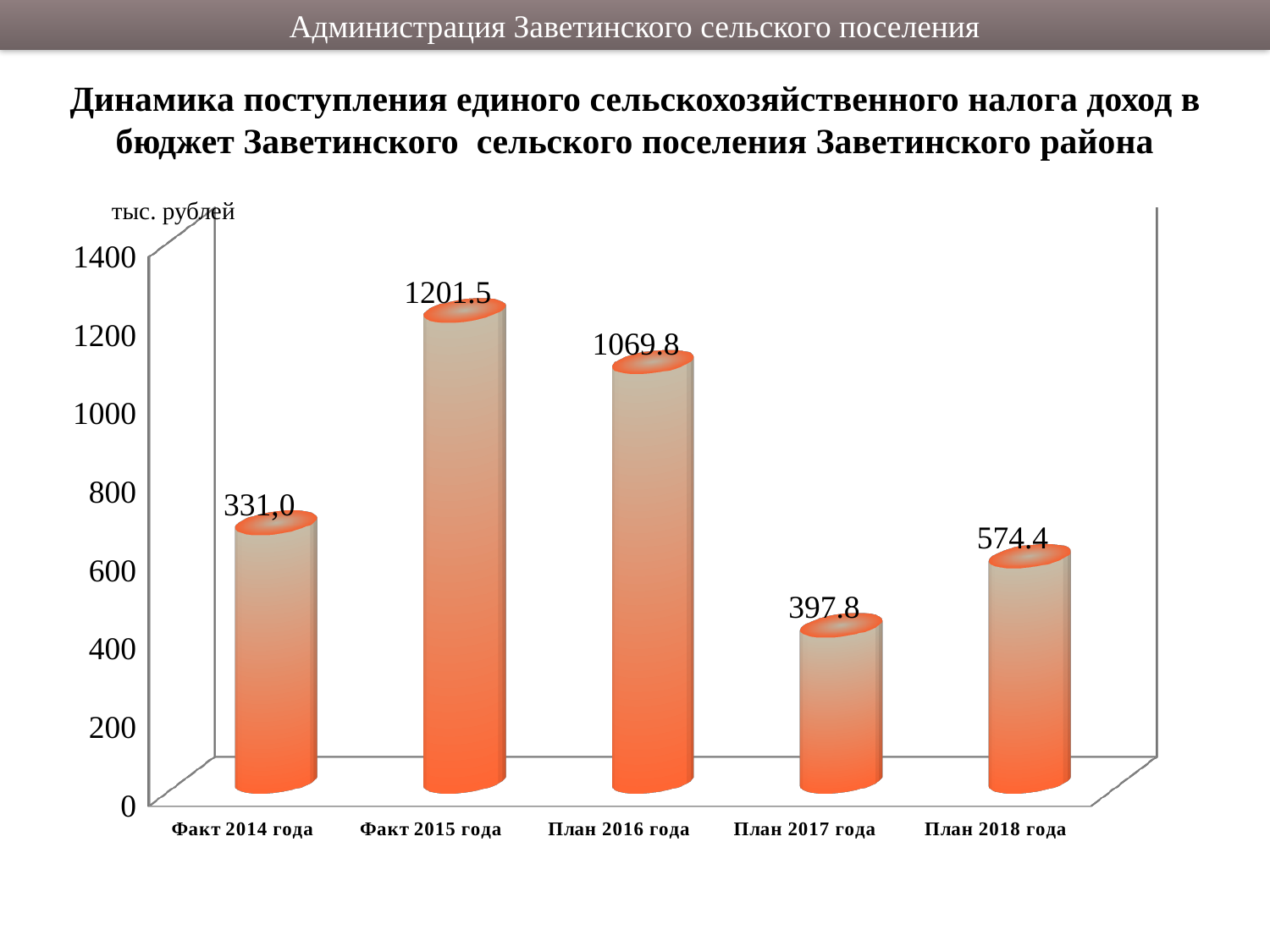
What is the difference between the values for План 2018 года and План 2017 года? 176.6 What is the difference between the values for Факт 2015 года and План 2016 года? 131.7 What value is labelled on the bar for Факт 2014 года? 331,0 What is the value for План 2016 года? 1069.8 Which is larger, the value for План 2016 года or the value for План 2018 года? План 2016 года How many categories are shown on the x axis? 5 What is the value for Факт 2015 года? 1201.5 Is the value for План 2016 года greater or less than 1000? greater What is the value for План 2017 года? 397.8 What kind of chart is shown on the slide? bar chart Which category has the highest value? Факт 2015 года What is the value for План 2018 года? 574.4